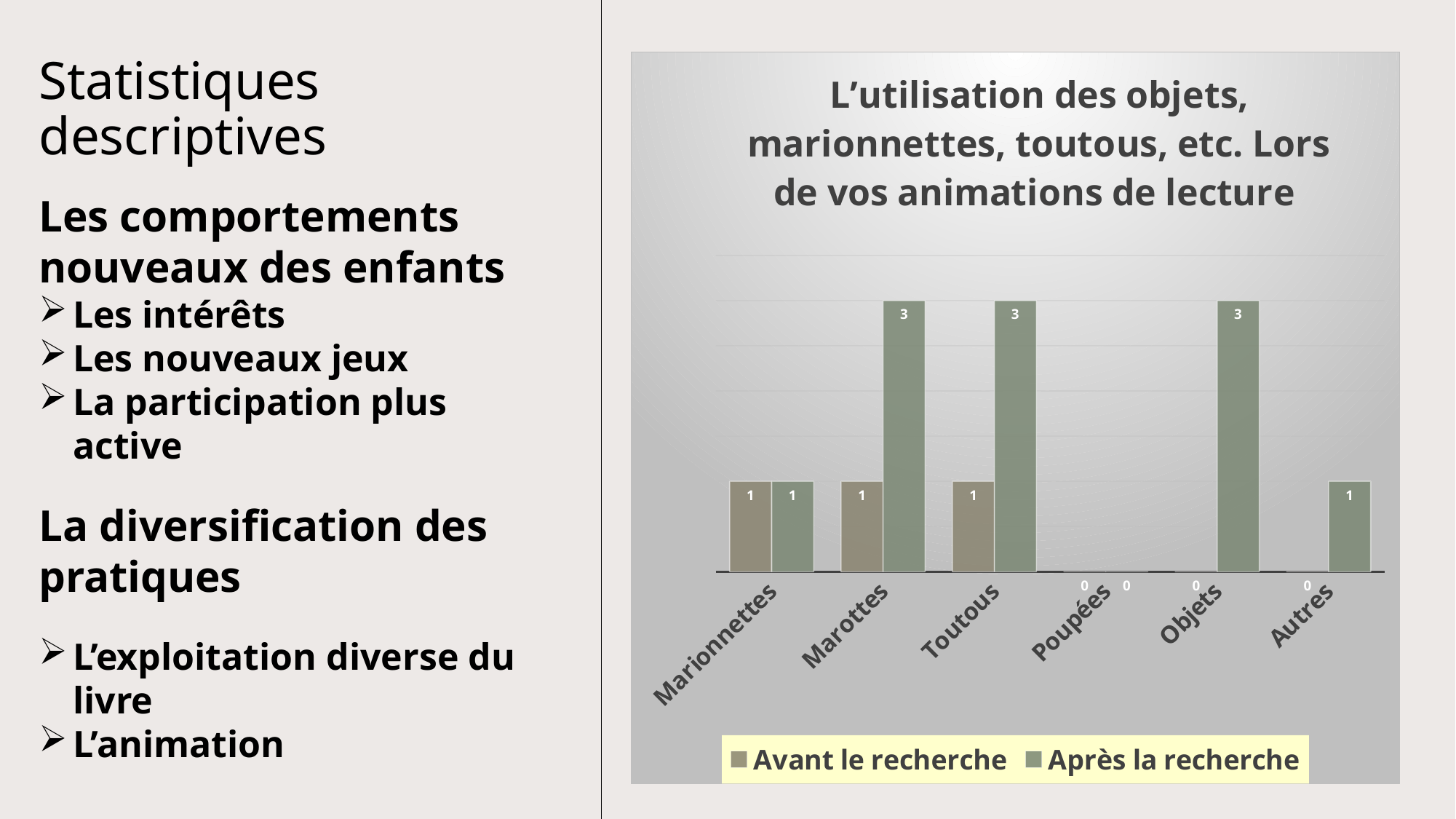
What is the value for Autres in the 'Après la recherche' series? 1 What is the value for Marottes in the 'Après la recherche' series? 3 What kind of chart is shown on the slide? bar chart What are the two legend entries of the chart? Avant le recherche, Après la recherche How many categories are shown on the x axis? 6 What is the value for Objets in the 'Avant le recherche' series? 0 What is the difference between the 'Après la recherche' and 'Avant le recherche' values for Objets? 3 Which is larger for Marottes: the 'Avant le recherche' value or the 'Après la recherche' value? Après la recherche What is the value for Toutous in the 'Avant le recherche' series? 1 Which category has the lowest value in the 'Après la recherche' series? Poupées How many series does the legend list? 2 What is the title of the chart? L'utilisation des objets, marionnettes, toutous, etc. Lors de vos animations de lecture